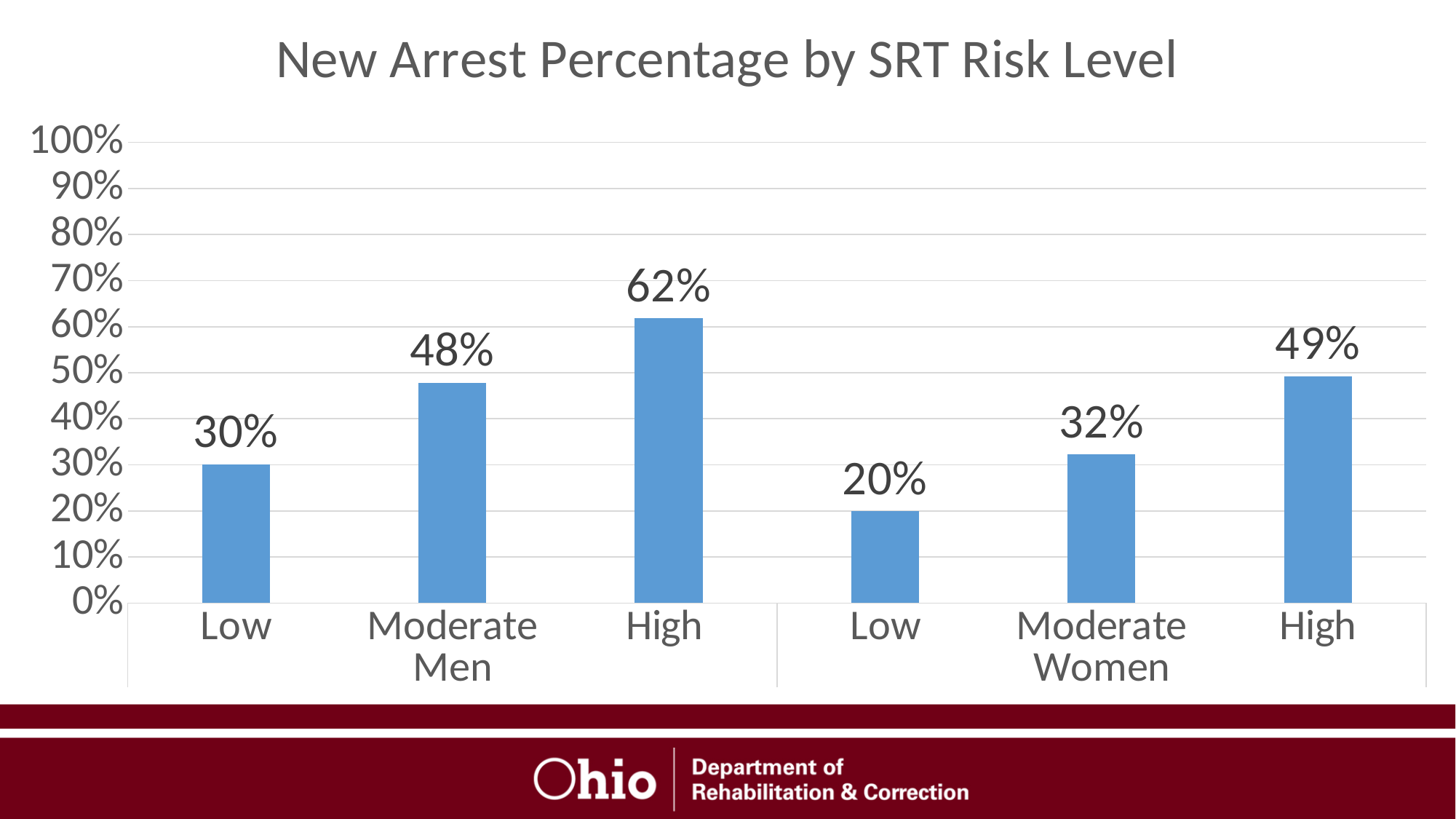
What is the new arrest percentage for Low risk Women? 20% What is the title of the chart? New Arrest Percentage by SRT Risk Level What is the difference between the new arrest percentage for Moderate risk Men and Moderate risk Women? 16% How many bars are plotted on the chart? 6 Which group has the highest new arrest percentage? High risk Men What is the difference between the new arrest percentage for High risk Men and High risk Women? 13% Is the value for High risk Women greater or less than 40%? greater What is the new arrest percentage for High risk Men? 62% What is the new arrest percentage for Moderate risk Men? 48% Which group has the lowest new arrest percentage? Low risk Women What kind of chart is shown on the slide? Bar chart Which is larger, the new arrest percentage for Low risk Men or Low risk Women? Low risk Men